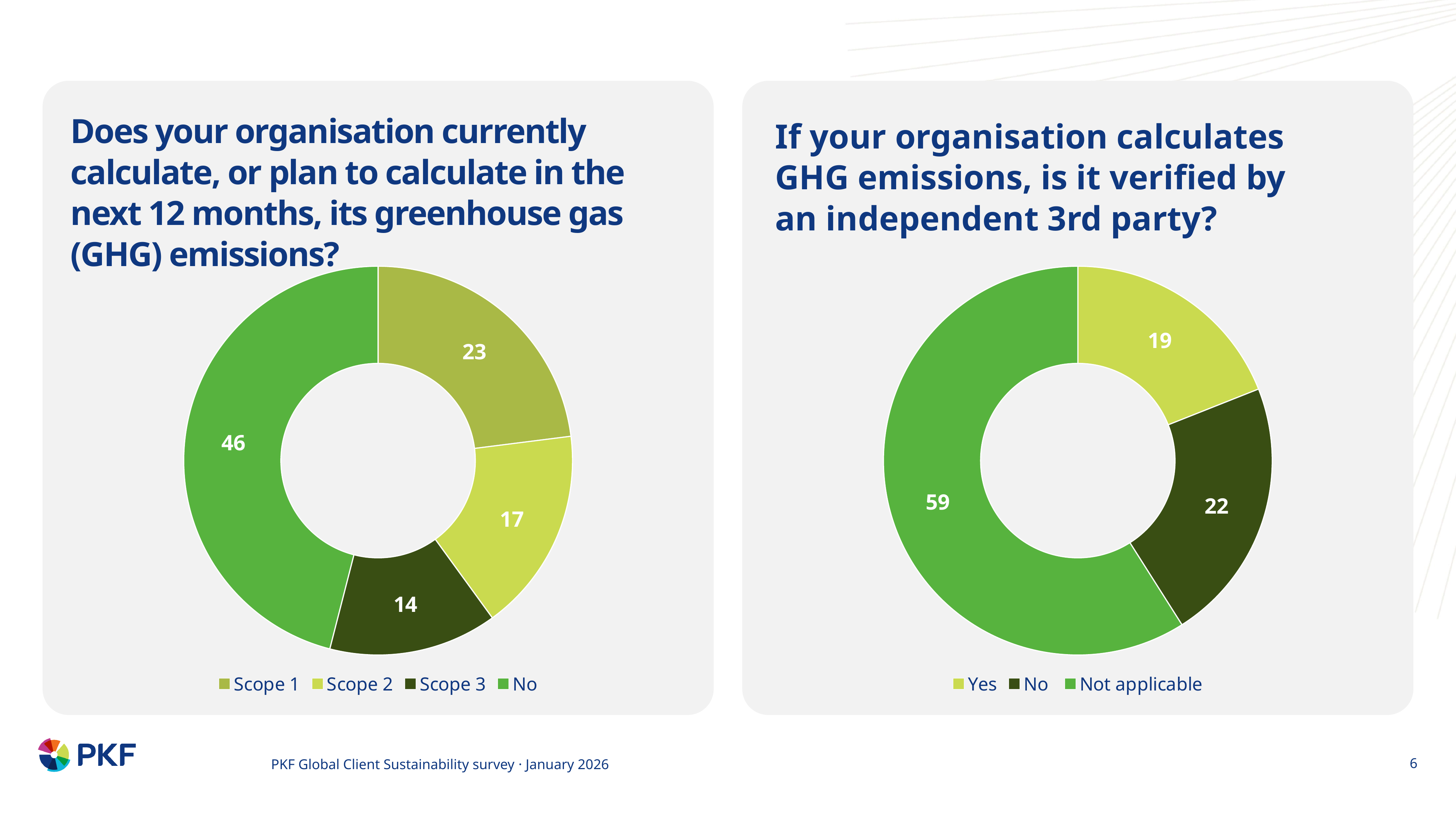
In the right chart, what is the value for "Not applicable"? 59 In the right chart, what is the total of the three slice values? 100 In the left chart, which category has the smallest slice? Scope 3 In the left chart, what is the value for the "No" slice? 46 In the right chart, which is larger, "Yes" or "No"? No What kind of chart is shown on the right side of the slide? Donut (pie) chart In the left chart ("Does your organisation currently calculate... GHG emissions?"), what is the value for Scope 1? 23 In the left chart, how many categories does the legend list? 4 In the right chart ("If your organisation calculates GHG emissions, is it verified by an independent 3rd party?"), what is the value for "Yes"? 19 In the left chart, which category has the largest slice? No In the right chart, what share of the total does the "Not applicable" slice represent? 59% In the left chart, what is the difference between the Scope 1 and Scope 2 values? 6